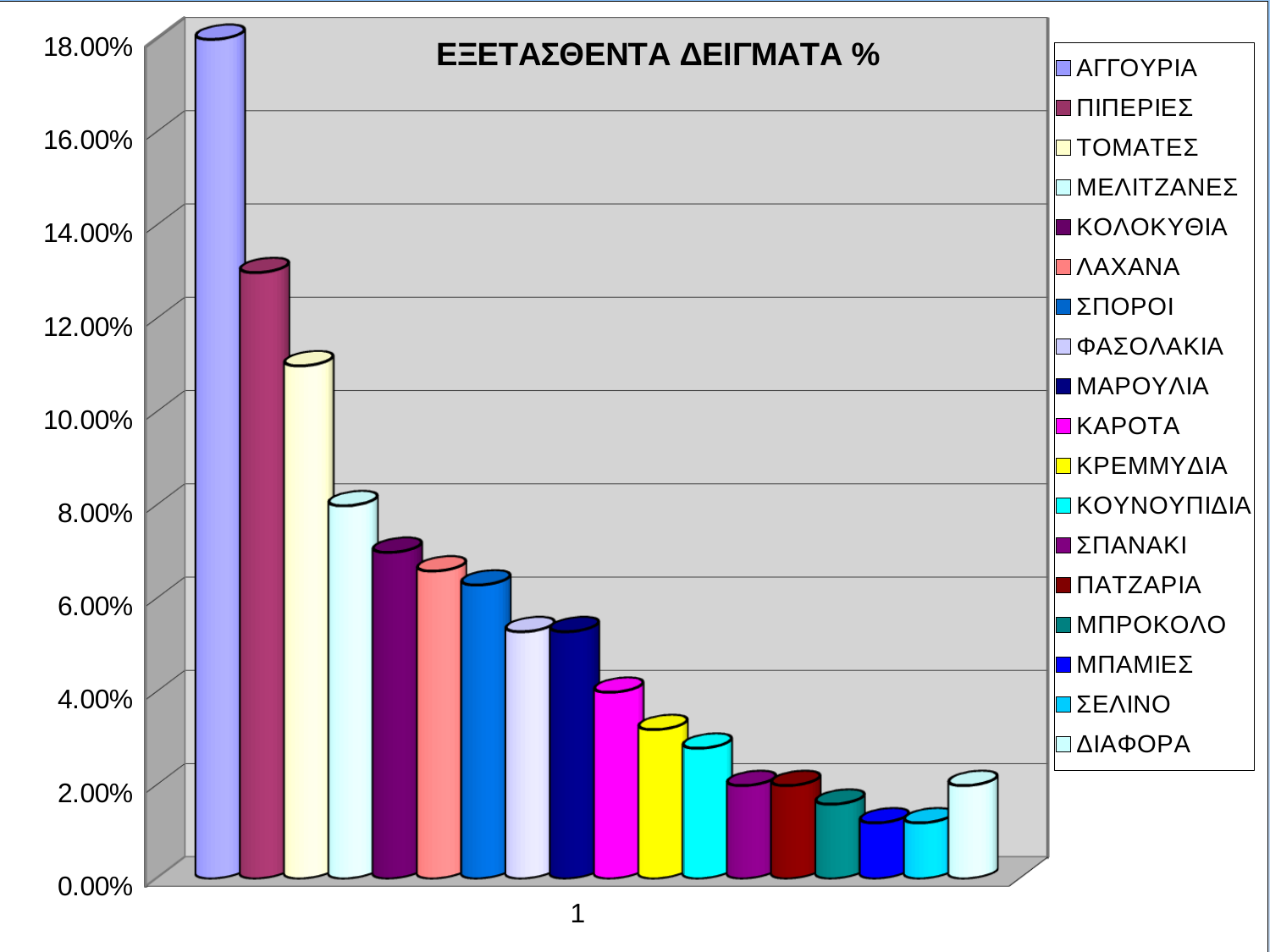
Is the value for ΠΙΠΕΡΙΕΣ greater or less than 12.00%? greater How many series does the legend list? 18 Is the value for ΜΠΑΜΙΕΣ greater or less than 2.00%? less Is the value for ΤΟΜΑΤΕΣ greater or less than 10.00%? greater Which is larger, the value for ΠΙΠΕΡΙΕΣ or the value for ΤΟΜΑΤΕΣ? ΠΙΠΕΡΙΕΣ What kind of chart is shown on the slide? bar chart Which is larger, the value for ΔΙΑΦΟΡΑ or the value for ΣΕΛΙΝΟ? ΔΙΑΦΟΡΑ What is the title of the chart? ΕΞΕΤΑΣΘΕΝΤΑ ΔΕΙΓΜΑΤΑ % Which series has the highest value? ΑΓΓΟΥΡΙΑ Which is larger, the value for ΚΑΡΟΤΑ or the value for ΚΡΕΜΜΥΔΙΑ? ΚΑΡΟΤΑ